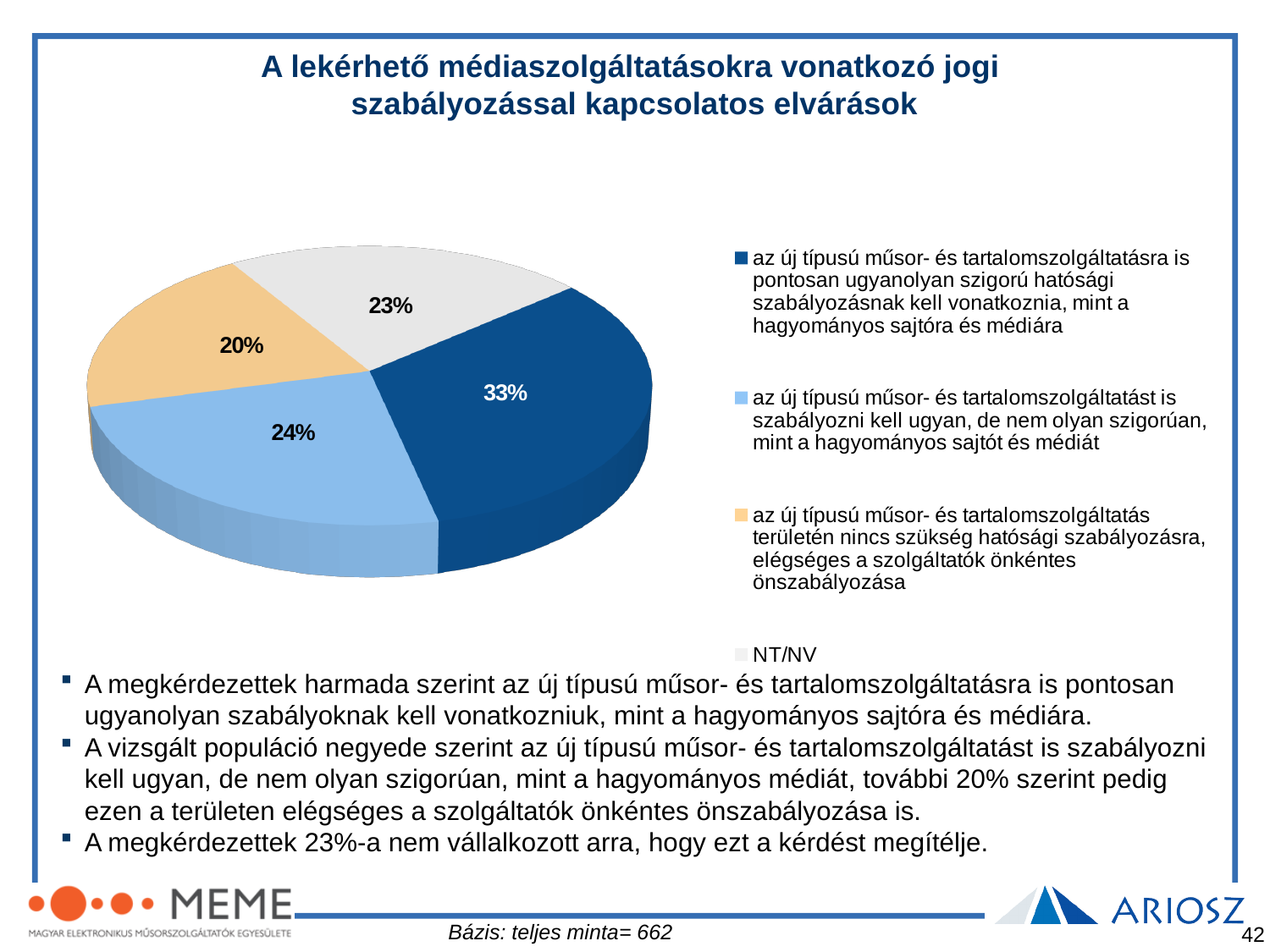
What share of respondents said the new services should be regulated, but not as strictly as traditional press and media (light blue slice)? 24% What share of respondents said no official regulation is needed and voluntary self-regulation is sufficient (orange slice)? 20% How many entries does the legend of the pie chart list? 4 How many slices does the pie chart have? 4 What kind of chart is shown on the slide? pie chart Which slice of the pie chart is the largest? 33% (same strict regulation as traditional press and media) What is the sample size (Bázis) stated below the chart? teljes minta= 662 Which is larger: the share for regulation that is less strict than traditional media (24%) or the share for voluntary self-regulation (20%)? 24% (less strict regulation) What is the difference in percentage points between the largest slice (33%) and the NT/NV slice (23%)? 10 percentage points Which slice of the pie chart is the smallest? 20% (voluntary self-regulation is sufficient) What share of respondents said the new type of programme and content services should be subject to exactly the same strict regulation as traditional press and media (dark blue slice)? 33% What share of respondents answered NT/NV (grey slice)? 23%